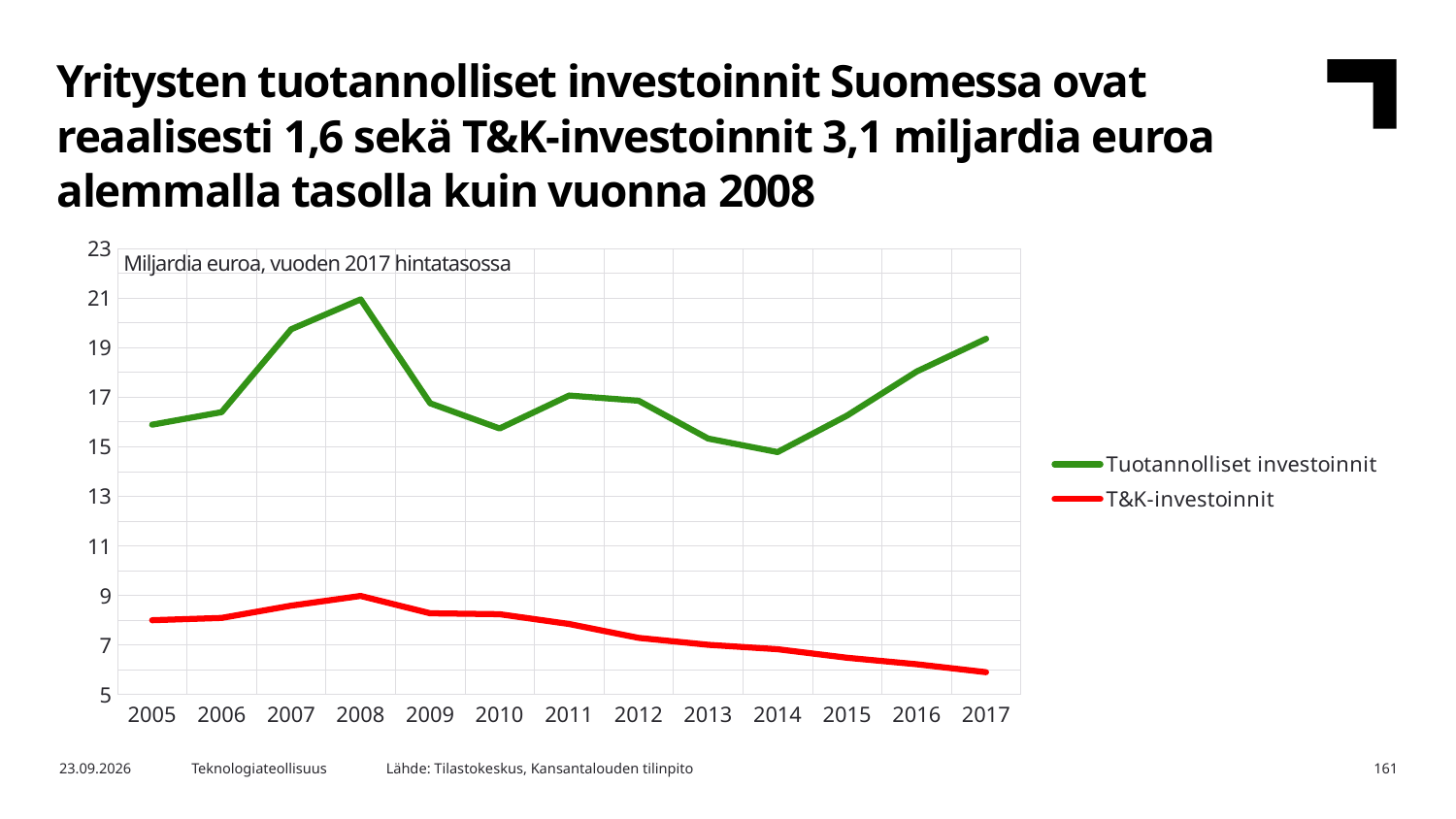
What unit note is printed inside the chart area? Miljardia euroa, vuoden 2017 hintatasossa How many years are plotted along the x axis? 13 Does the T&K-investoinnit series generally rise or fall from 2008 to 2017? fall Is the value for T&K-investoinnit in 2017 greater or less than 7? less In which year is the Tuotannolliset investoinnit series at its lowest? 2014 In which year is the Tuotannolliset investoinnit series at its highest? 2008 In which year is the T&K-investoinnit series at its highest? 2008 In which year is the T&K-investoinnit series at its lowest? 2017 Is the value for Tuotannolliset investoinnit in 2008 greater or less than 19? greater Which is larger: Tuotannolliset investoinnit in 2007 or in 2009? 2007 How many series does the legend list? 2 What kind of chart is shown on the slide? line chart